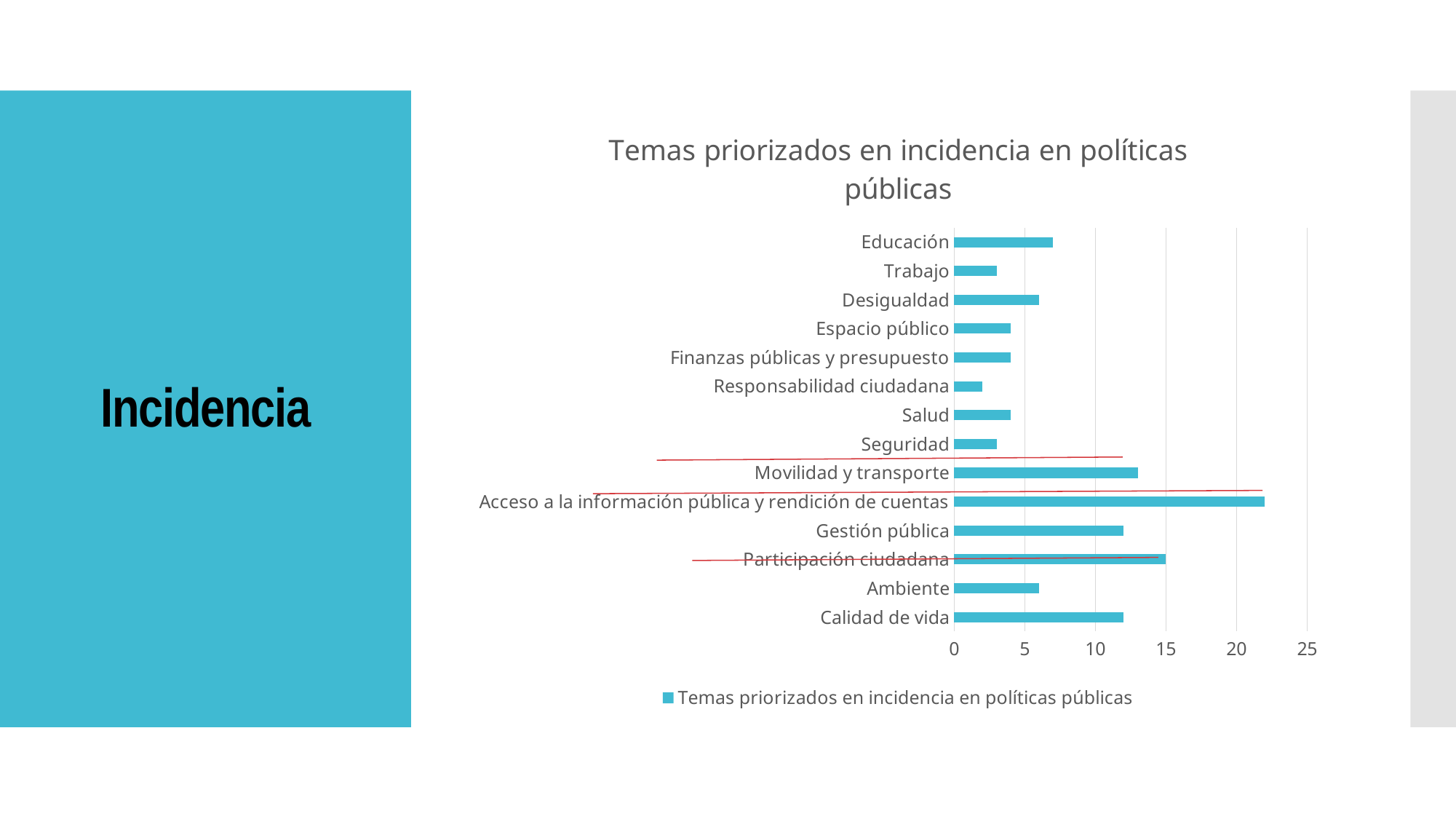
Is the value for Trabajo greater or less than 5? less Which is larger, the value for Participación ciudadana or the value for Ambiente? Participación ciudadana Which is larger, the value for Educación or the value for Trabajo? Educación What kind of chart is shown on the slide? Bar chart Is the value for Acceso a la información pública y rendición de cuentas greater or less than 20? greater Is the value for Movilidad y transporte greater or less than 10? greater Which category has the highest value? Acceso a la información pública y rendición de cuentas What is the title of the chart? Temas priorizados en incidencia en políticas públicas Which category has the lowest value? Responsabilidad ciudadana How many series does the legend list? 1 How many categories are plotted in the chart? 14